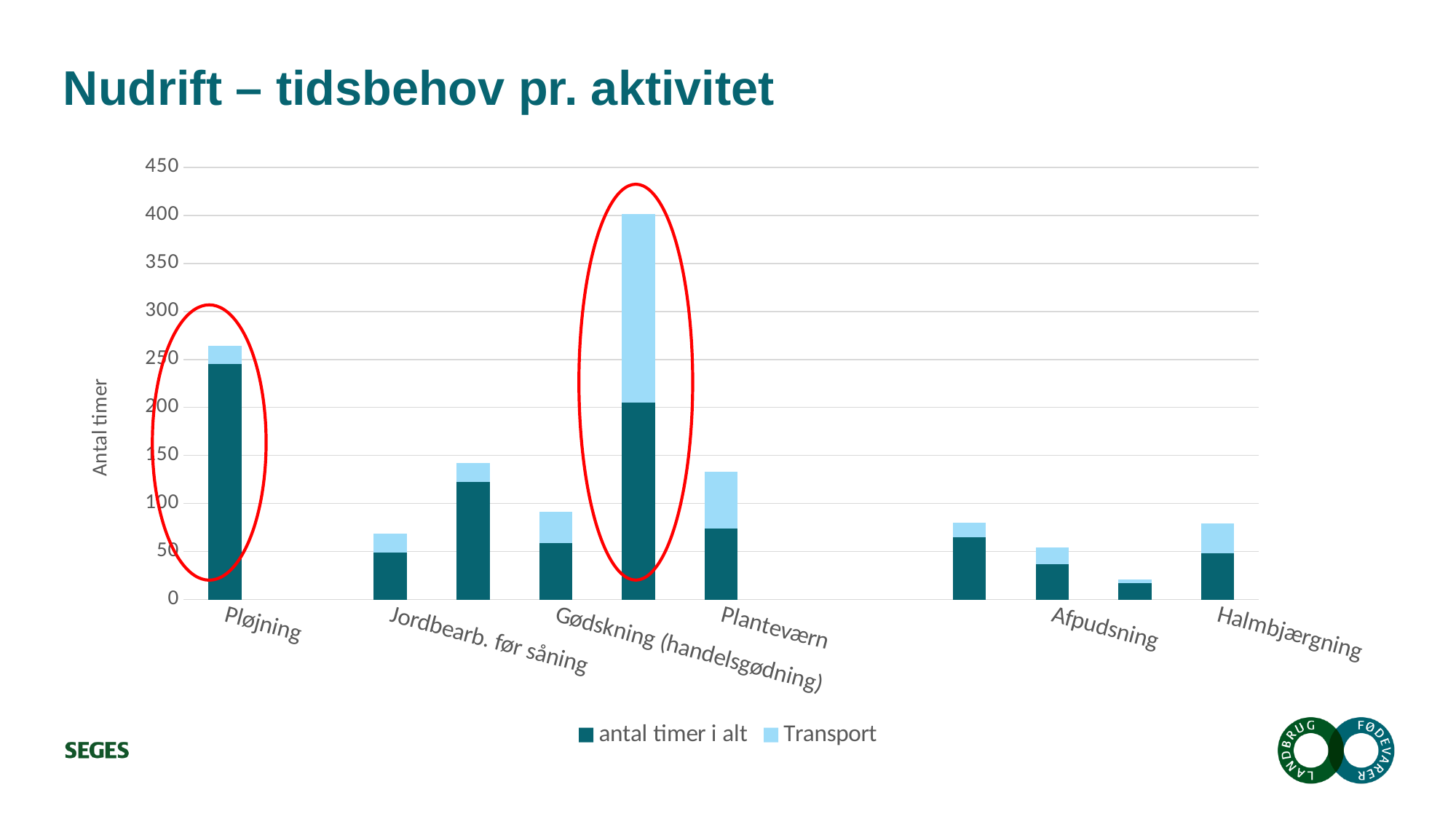
Is the total bar for Pløjning greater or less than 250? greater Is the total bar for Jordbearb. før såning greater or less than 150? less Is the total bar for Planteværn greater or less than 100? greater What are the two series named in the legend? antal timer i alt, Transport How many series does the legend list? 2 Which has the larger total bar, Pløjning or Planteværn? Pløjning What kind of chart is shown on the slide? stacked bar chart What is the title of the chart on the slide? Nudrift – tidsbehov pr. aktivitet